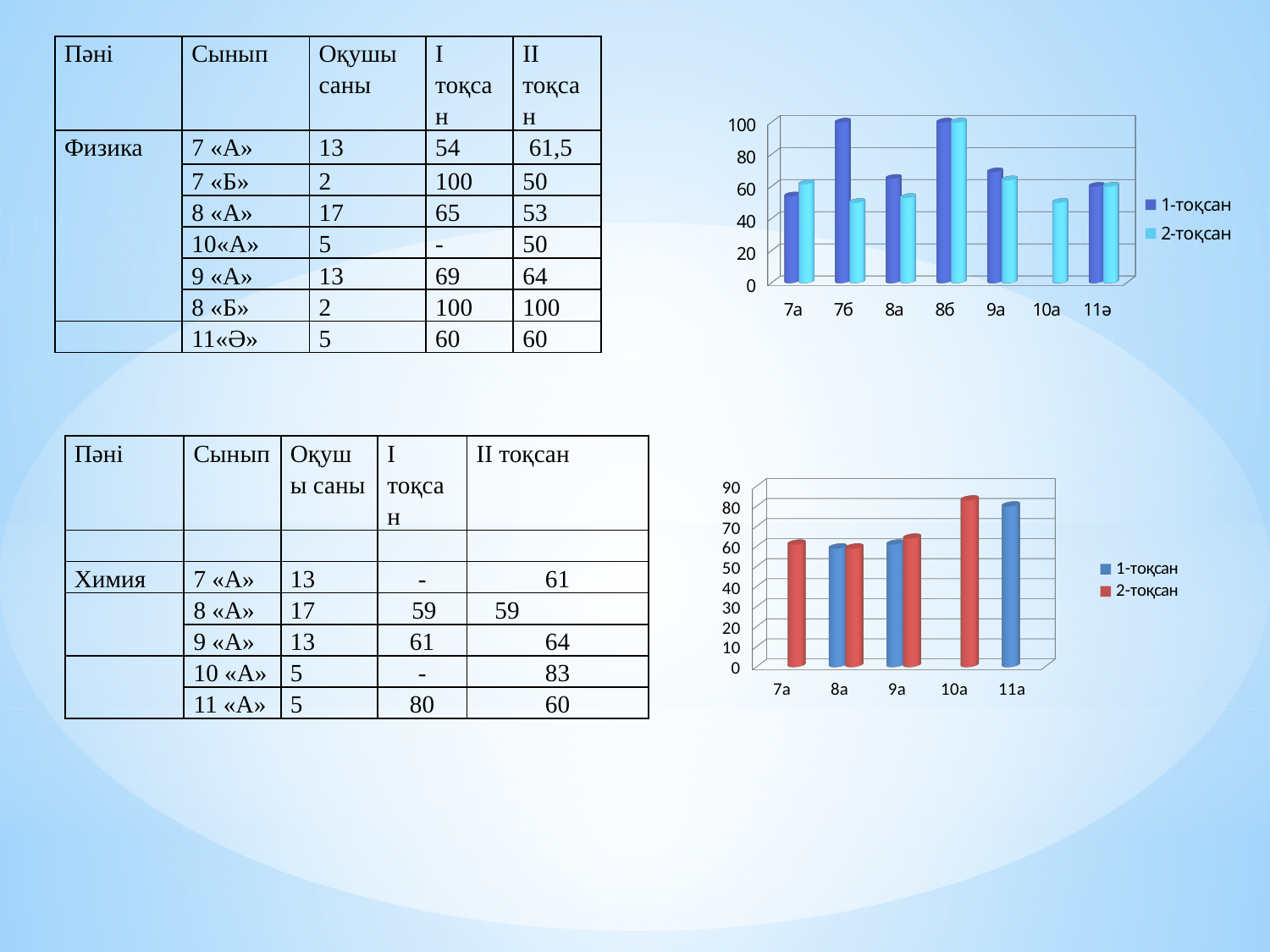
In the top-right chart, is the 1-тоқсан value for 7б greater or less than 80? greater How many series does the legend of the top-right chart list? 2 In the bottom-right chart, is the 2-тоқсан value for 7a greater or less than 70? less How many categories are shown on the x axis of the bottom-right chart? 5 In the top-right chart, which is larger for 7б: the 1-тоқсан value or the 2-тоқсан value? 1-тоқсан In the bottom-right chart, which category has the highest 1-тоқсан value? 11a In the top-right chart, is the 2-тоқсан value for 7а greater or less than 80? less What kind of chart is the top-right chart? bar chart In the bottom-right chart, what colour represents the 2-тоқсан series? red How many categories are shown on the x axis of the top-right chart? 7 In the top-right chart, which category has the highest 2-тоқсан value? 8б In the bottom-right chart, which category has the highest 2-тоқсан value? 10a